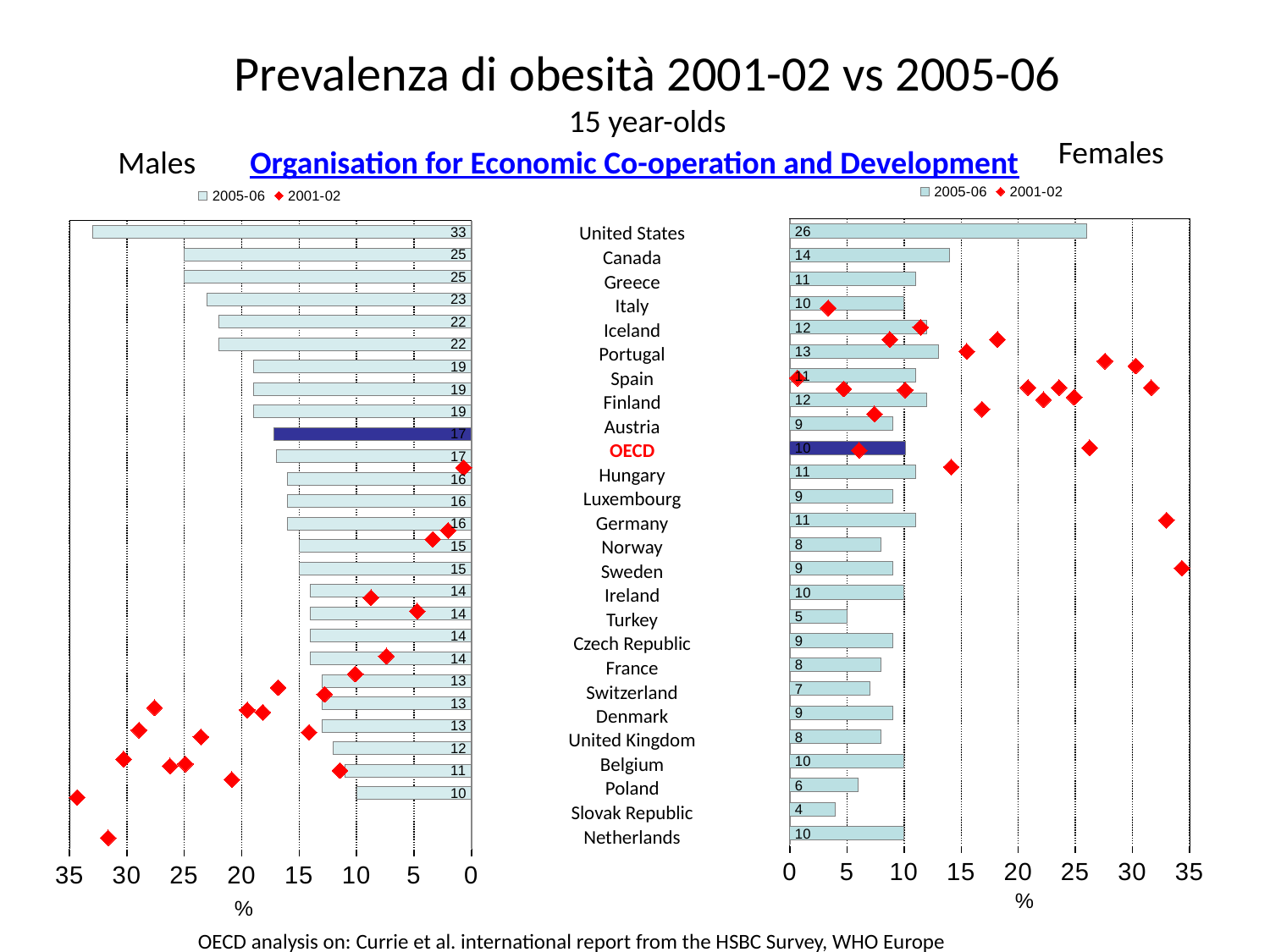
In the Females chart, what is the 2005-06 value for Turkey? 5 In the Females chart, which country has the highest 2005-06 value? United States In the Males chart, which has the larger 2005-06 value, Italy or Spain? Italy In the Females chart, what is the difference between the 2005-06 values for the United States and Portugal? 13 In the Females chart, which country has the lowest 2005-06 value? Slovak Republic In the Males chart, what is the 2005-06 value for the OECD? 17 What kind of chart is the Females chart? Bar chart In the Males chart, what is the difference between the 2005-06 values for the United States and Canada? 8 In the Males chart, which country has the lowest 2005-06 value? Netherlands How many series does the legend of the Males chart list? 2 In the Males chart, what is the 2005-06 obesity prevalence for the United States? 33 In the Females chart, what is the 2005-06 obesity prevalence for Canada? 14